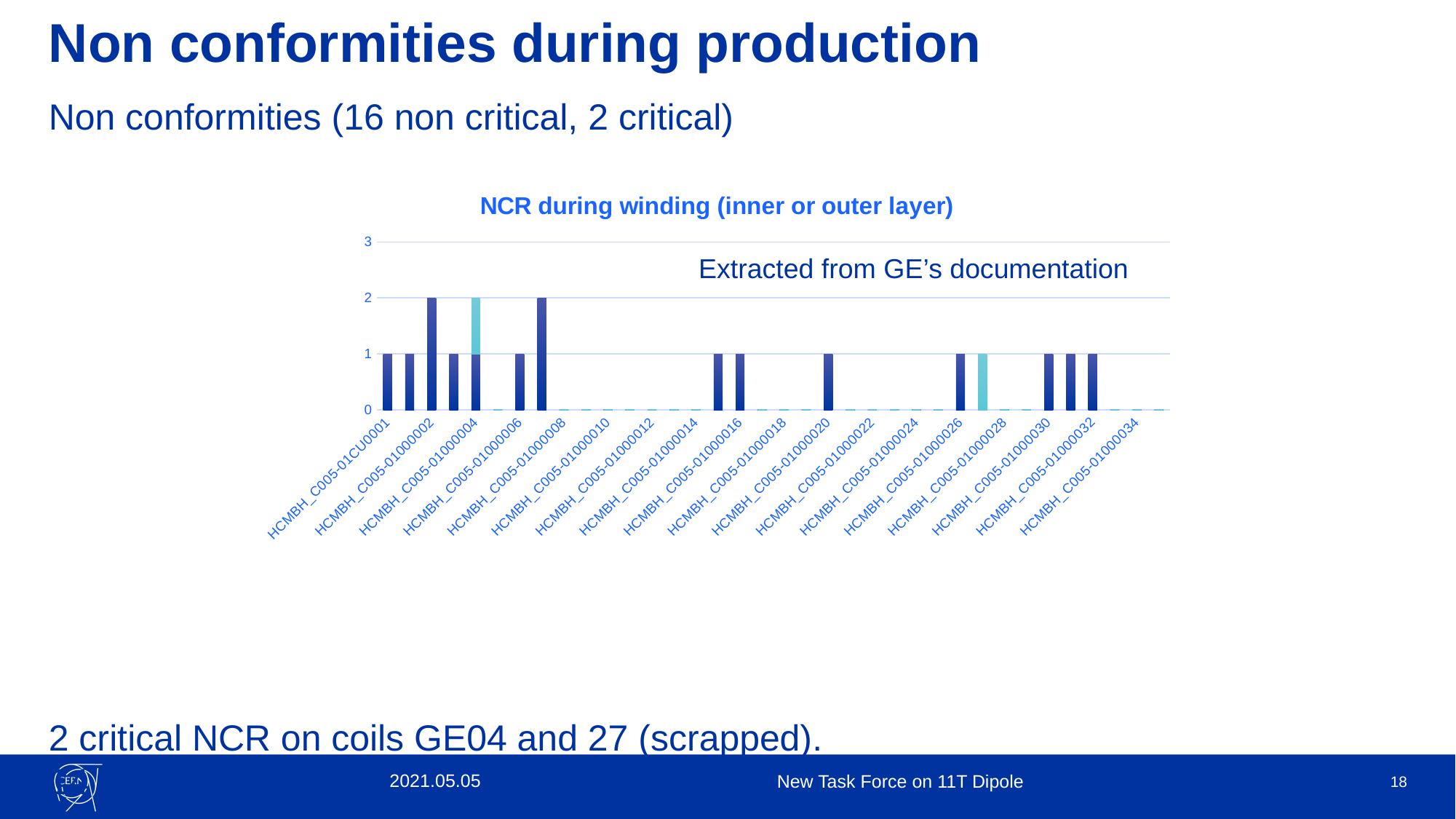
What is the value for HCMBH_C005-01000020? 1 What is the value for HCMBH_C005-01000006? 1 What is the highest value reached by any bar in the chart? 2 What is the value for HCMBH_C005-01000002? 2 Which is larger, the value for HCMBH_C005-01000002 or the value for HCMBH_C005-01000006? HCMBH_C005-01000002 What is the value for HCMBH_C005-01000004? 2 What is the difference between the value for HCMBH_C005-01000002 and the value for HCMBH_C005-01000030? 1 What is the value for HCMBH_C005-01000016? 1 What kind of chart is shown on the slide? bar chart What is the value for HCMBH_C005-01000010? 0 What is the title of the chart? NCR during winding (inner or outer layer) Is the value for HCMBH_C005-01000004 greater or less than 1? greater